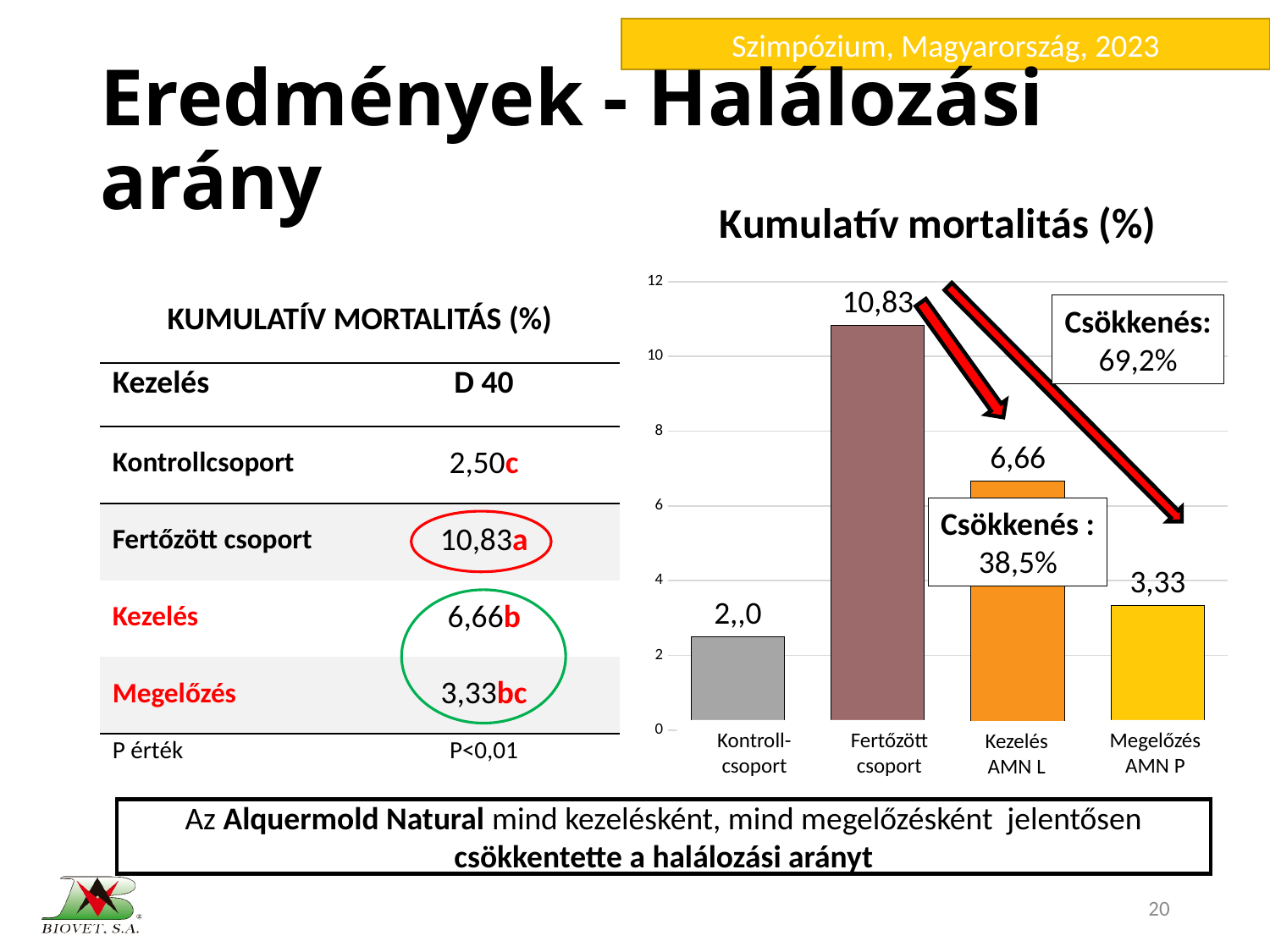
What type of chart is shown on the slide? bar chart What is the value for Fertőzött csoport in the chart? 10,83 What is the value for Megelőzés AMN P in the chart? 3,33 What is the difference between the values for Fertőzött csoport and Kezelés AMN L? 4,17 Which category has the highest value in the chart? Fertőzött csoport Which category has the lowest value in the chart? Kontroll-csoport What is the title of the chart? Kumulatív mortalitás (%) What is the value for Kezelés AMN L in the chart? 6,66 Which is larger, the value for Kezelés AMN L or the value for Megelőzés AMN P? Kezelés AMN L What is the difference between the values for Kezelés AMN L and Megelőzés AMN P? 3,33 Is the value for Kontroll-csoport greater or less than 4? less How many categories are plotted in the chart? 4